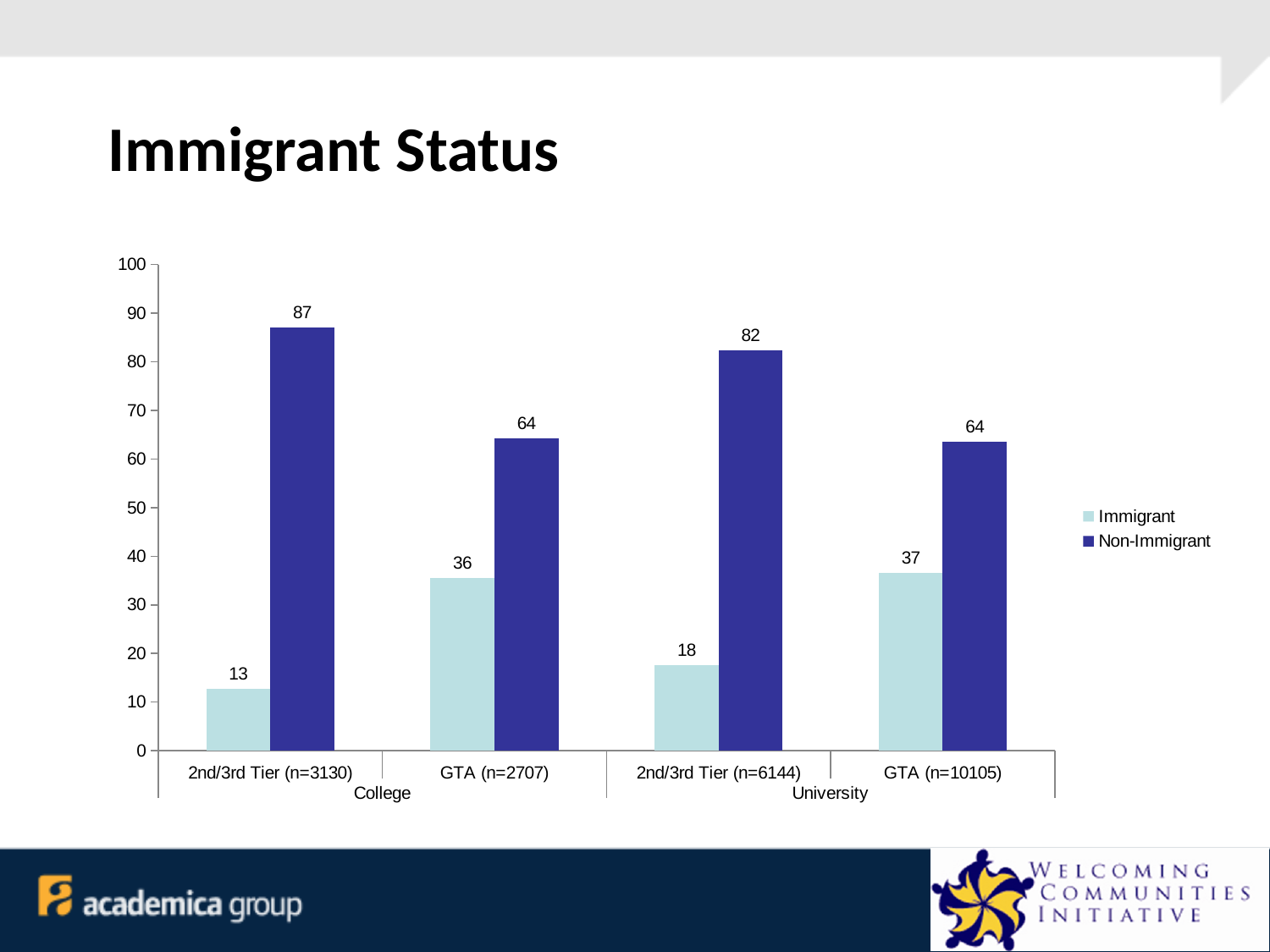
Which category has the highest Non-Immigrant value? 2nd/3rd Tier (n=3130) Which category has the lowest Immigrant value? 2nd/3rd Tier (n=3130) How many series does the legend list? 2 Which is larger, the Immigrant value for GTA (n=2707) or the Immigrant value for 2nd/3rd Tier (n=6144)? GTA (n=2707) What is the difference between the Non-Immigrant and Immigrant values for 2nd/3rd Tier (n=6144) under University? 64 What is the Immigrant value for 2nd/3rd Tier (n=3130) under College? 13 How many categories are shown on the x axis? 4 Which series is shown in dark blue? Non-Immigrant What is the Non-Immigrant value for GTA (n=10105) under University? 64 What kind of chart is shown on the slide? Bar chart What is the title of the slide? Immigrant Status What is the Immigrant value for GTA (n=2707) under College? 36